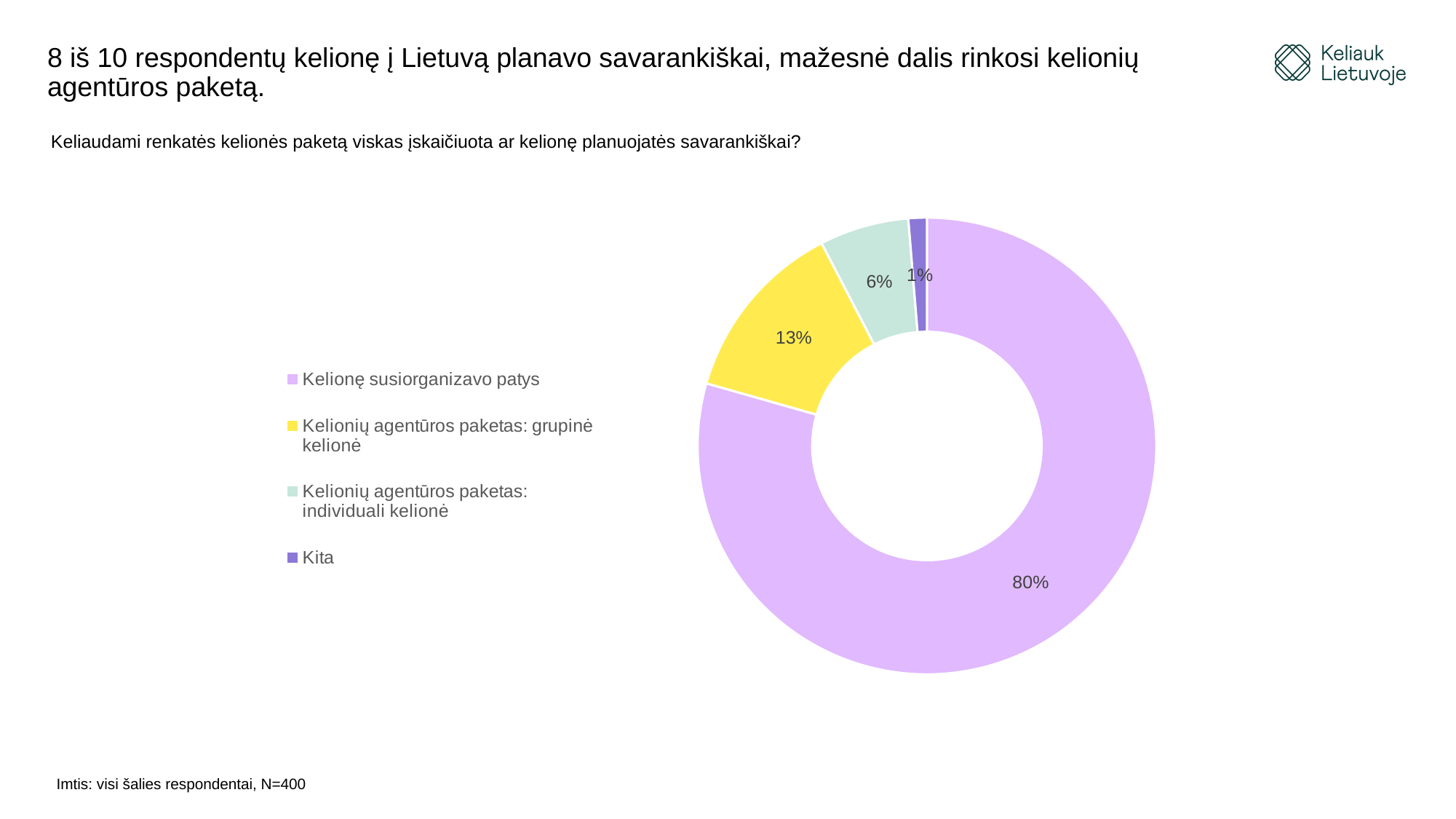
What share of respondents chose "Kelionę susiorganizavo patys"? 80% Which is larger: the share for "Kelionių agentūros paketas: grupinė kelionė" or for "Kelionių agentūros paketas: individuali kelionė"? Kelionių agentūros paketas: grupinė kelionė What is the difference in percentage points between "Kelionę susiorganizavo patys" and "Kelionių agentūros paketas: grupinė kelionė"? 67 percentage points Which category has the smallest share of the pie? Kita What share of respondents chose "Kelionių agentūros paketas: grupinė kelionė"? 13% How many categories does the pie chart show? 4 Which category has the largest share of the pie? Kelionę susiorganizavo patys What colour is the slice for "Kita"? Purple What share of respondents chose "Kita"? 1% What share of respondents chose "Kelionių agentūros paketas: individuali kelionė"? 6% What is the combined share of the two "Kelionių agentūros paketas" categories? 19% What kind of chart is shown on the slide? Pie chart (doughnut)